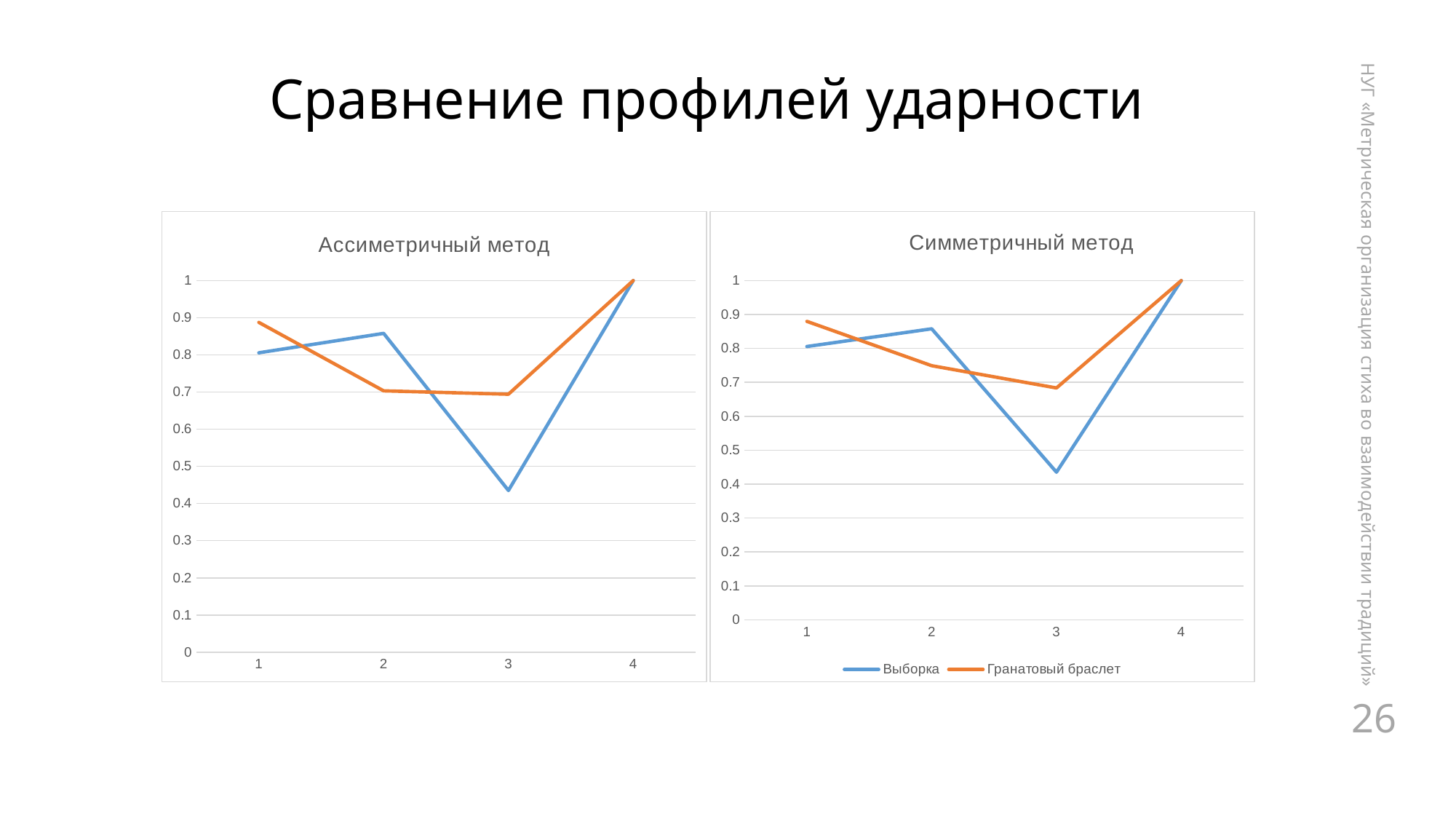
In the left chart "Ассиметричный метод", how many points are plotted along the x axis for each line? 4 In the left chart "Ассиметричный метод", is the value of the orange line at x = 1 greater or less than 0.8? greater In the right chart "Симметричный метод", at which x value does Выборка reach its lowest point? 3 In the right chart "Симметричный метод", is the value of Гранатовый браслет at x = 3 greater or less than 0.6? greater In the right chart "Симметричный метод", does the Гранатовый браслет line rise or fall from x = 1 to x = 3? fall What kind of chart is the left chart titled "Ассиметричный метод"? line chart What is the title of the right chart? Симметричный метод In the right chart "Симметричный метод", which series has the larger value at x = 2, Выборка or Гранатовый браслет? Выборка In the left chart "Ассиметричный метод", is the value of the blue line at x = 3 greater or less than 0.5? less In the right chart "Симметричный метод", what is the value of Выборка at x = 4? 1 In the right chart "Симметричный метод", how many series does the legend list? 2 In the left chart "Ассиметричный метод", which line is higher at x = 1, the blue line or the orange line? the orange line